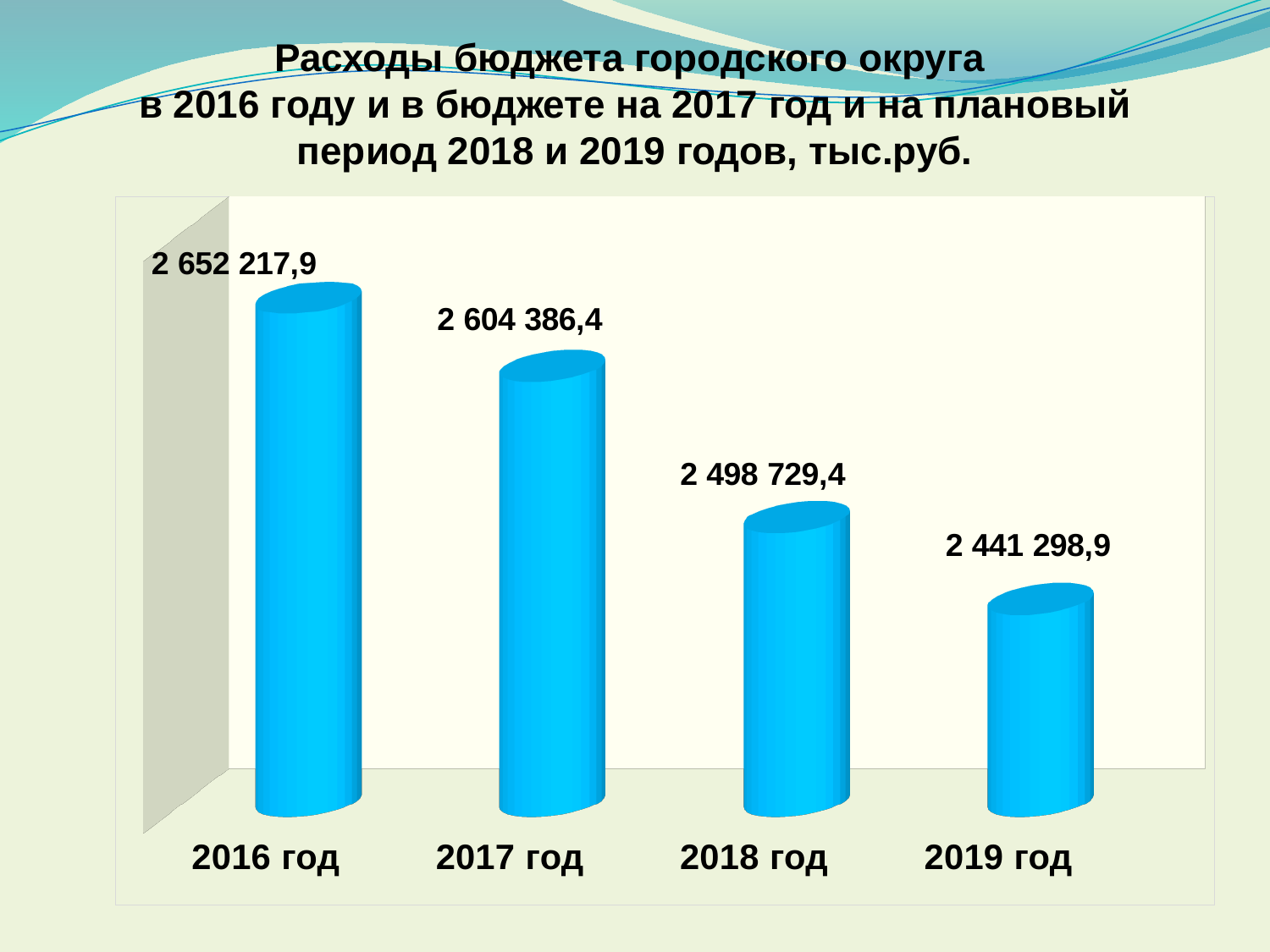
What is the difference between the values for 2016 год and 2017 год? 47 831,5 What is the difference between the values for 2018 год and 2019 год? 57 430,5 How many years are shown on the chart? 4 What kind of chart is shown on the slide? Bar chart What is the value for 2016 год? 2 652 217,9 Which is larger, the value for 2017 год or the value for 2018 год? 2017 год Which year has the highest value? 2016 год What is the value for 2019 год? 2 441 298,9 Do the values rise or fall from 2016 год to 2019 год? Fall Which year has the lowest value? 2019 год What is the value for 2018 год? 2 498 729,4 What is the value for 2017 год? 2 604 386,4